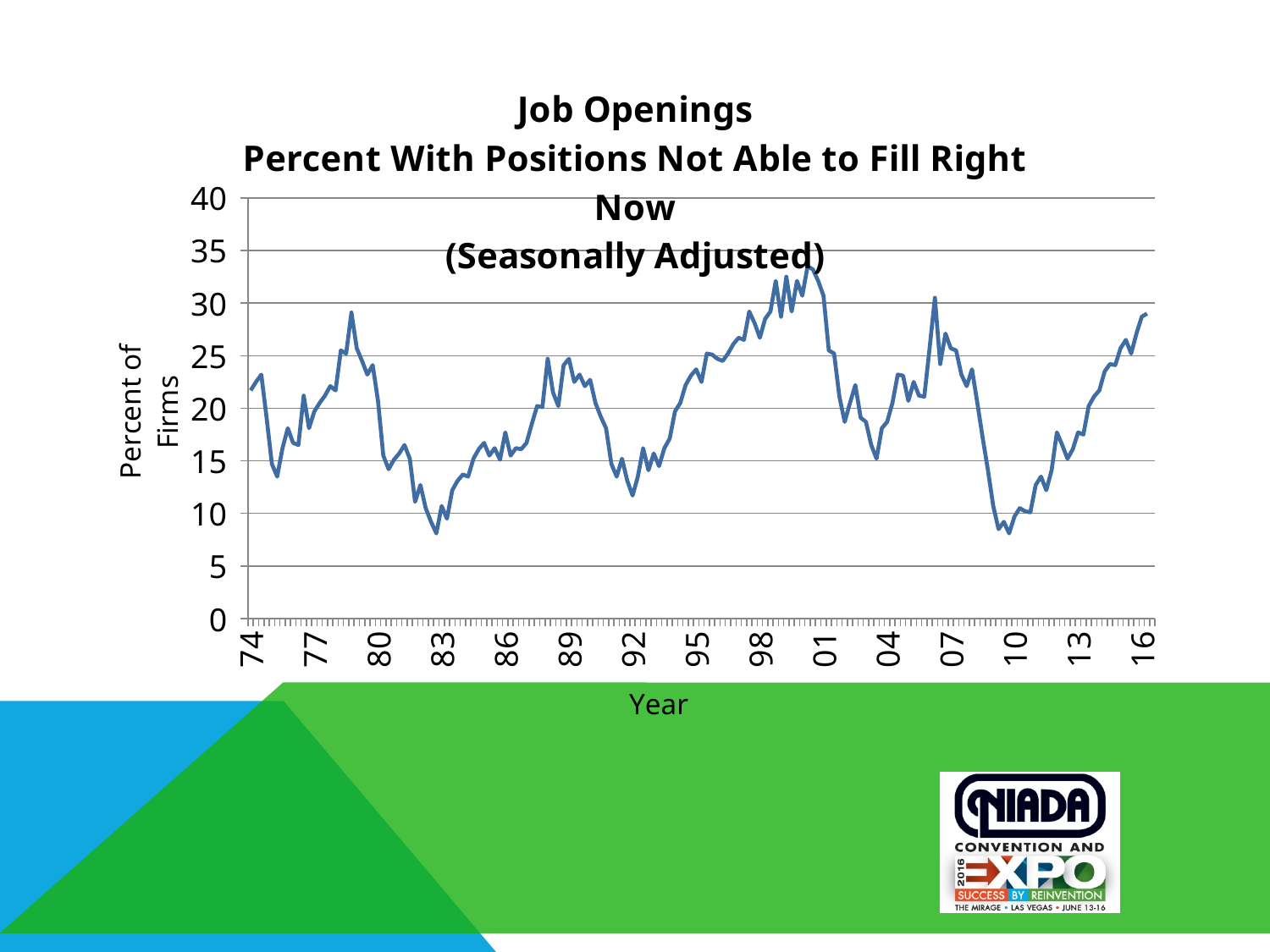
Does the line rise or fall between the 10 and 16 ticks on the x axis? rise What is the label on the vertical axis? Percent of Firms Is the highest point of the line closer to the 01 tick or the 07 tick on the x axis? 01 Is the value of the line higher at the 01 tick or at the 10 tick on the x axis? 01 What kind of chart is shown on the slide? line chart Is the value of the line at the 16 tick on the x axis greater or less than 25? greater What is the title of the chart? Job Openings Percent With Positions Not Able to Fill Right Now (Seasonally Adjusted) Is the value of the line at the 83 tick on the x axis greater or less than 15? less Does the line rise or fall between the 07 and 10 ticks on the x axis? fall Is the value of the line at the 92 tick on the x axis greater or less than 15? less